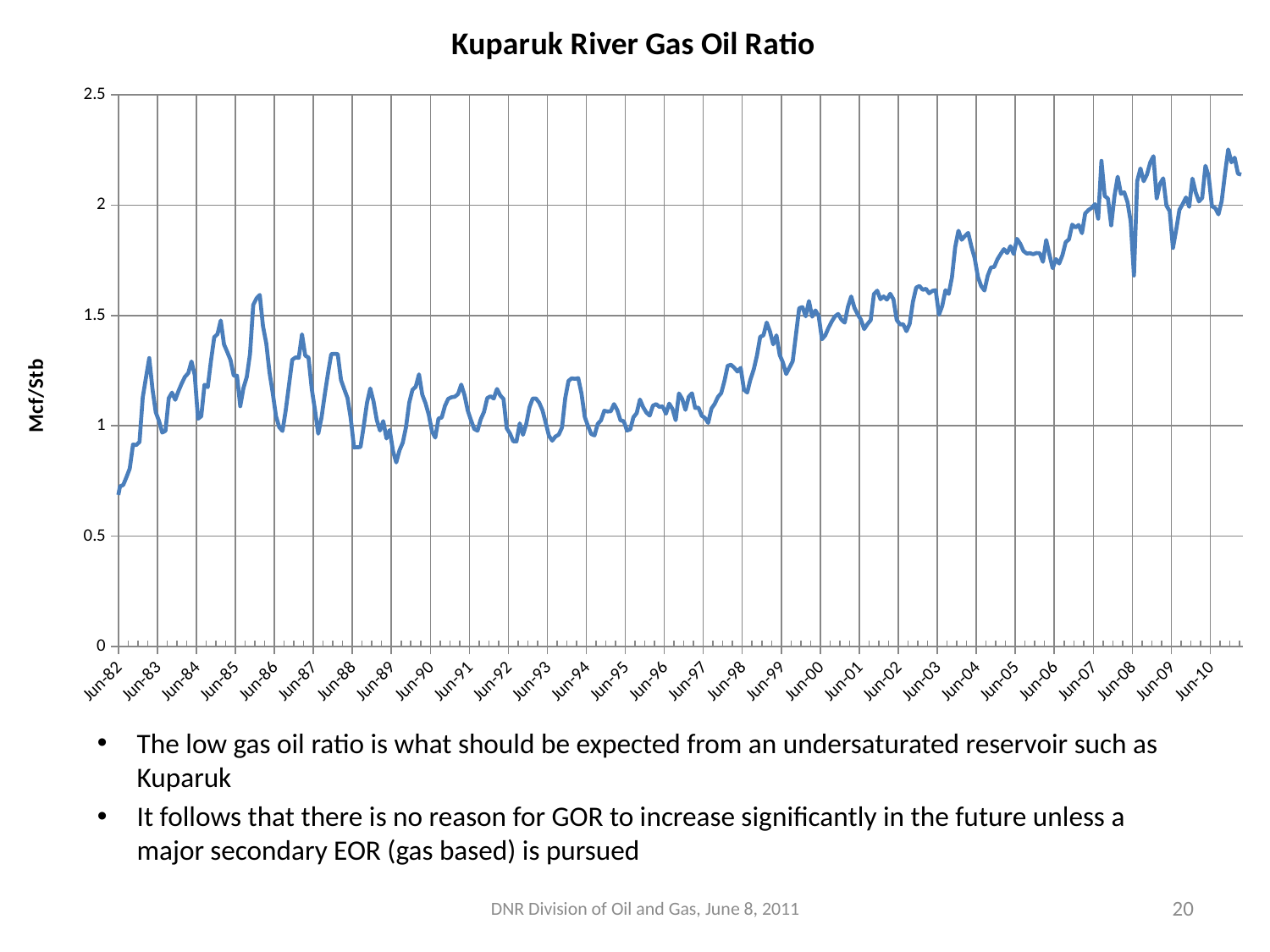
Which is larger, the value for Jun-82 or the value for Jun-10? Jun-10 Overall, does the gas oil ratio rise or fall from Jun-82 to Jun-10? rise What is the title of the chart? Kuparuk River Gas Oil Ratio Is the value for Jun-89 greater or less than 1? less What is the label on the vertical axis of the chart? Mcf/Stb Which is larger, the value for Jun-89 or the value for Jun-04? Jun-04 Is the value for Jun-82 greater or less than 1? less How many date labels are shown along the x axis? 29 What kind of chart is shown on the slide? line chart Is the value for Jun-04 greater or less than 1.5? greater